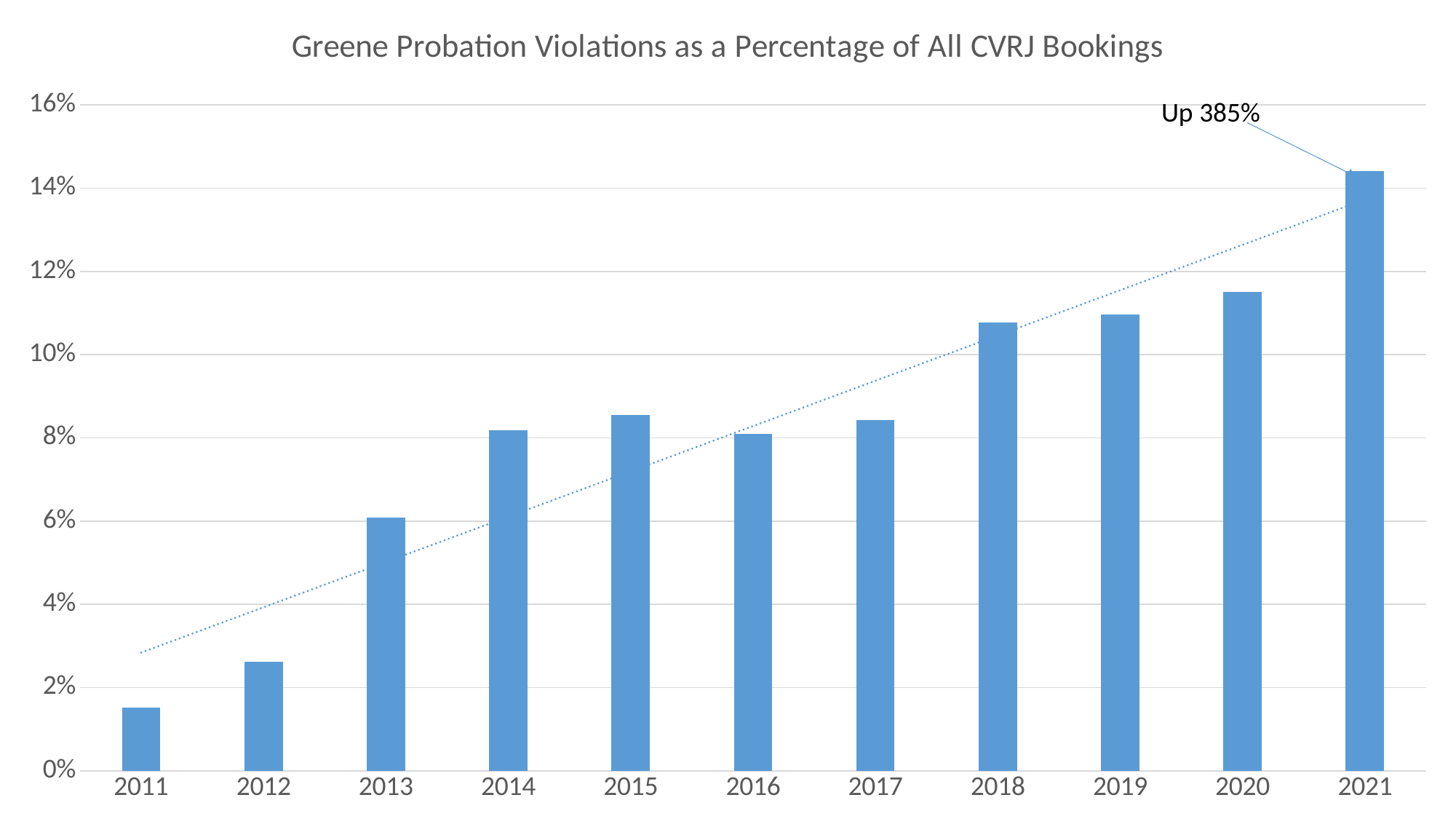
Is the value for 2013 greater or less than 8%? less Is the value for 2021 greater or less than 14%? greater Is the value for 2018 greater or less than 10%? greater Which year has the lowest percentage? 2011 What is the title of the chart? Greene Probation Violations as a Percentage of All CVRJ Bookings Which year has the highest percentage? 2021 Which year has the larger value, 2013 or 2014? 2014 Do the values generally rise or fall from 2011 to 2021? Rise How many years are plotted on the x axis? 11 What does the annotation pointing to the 2021 bar say? Up 385% What kind of chart is shown on the slide? Bar chart